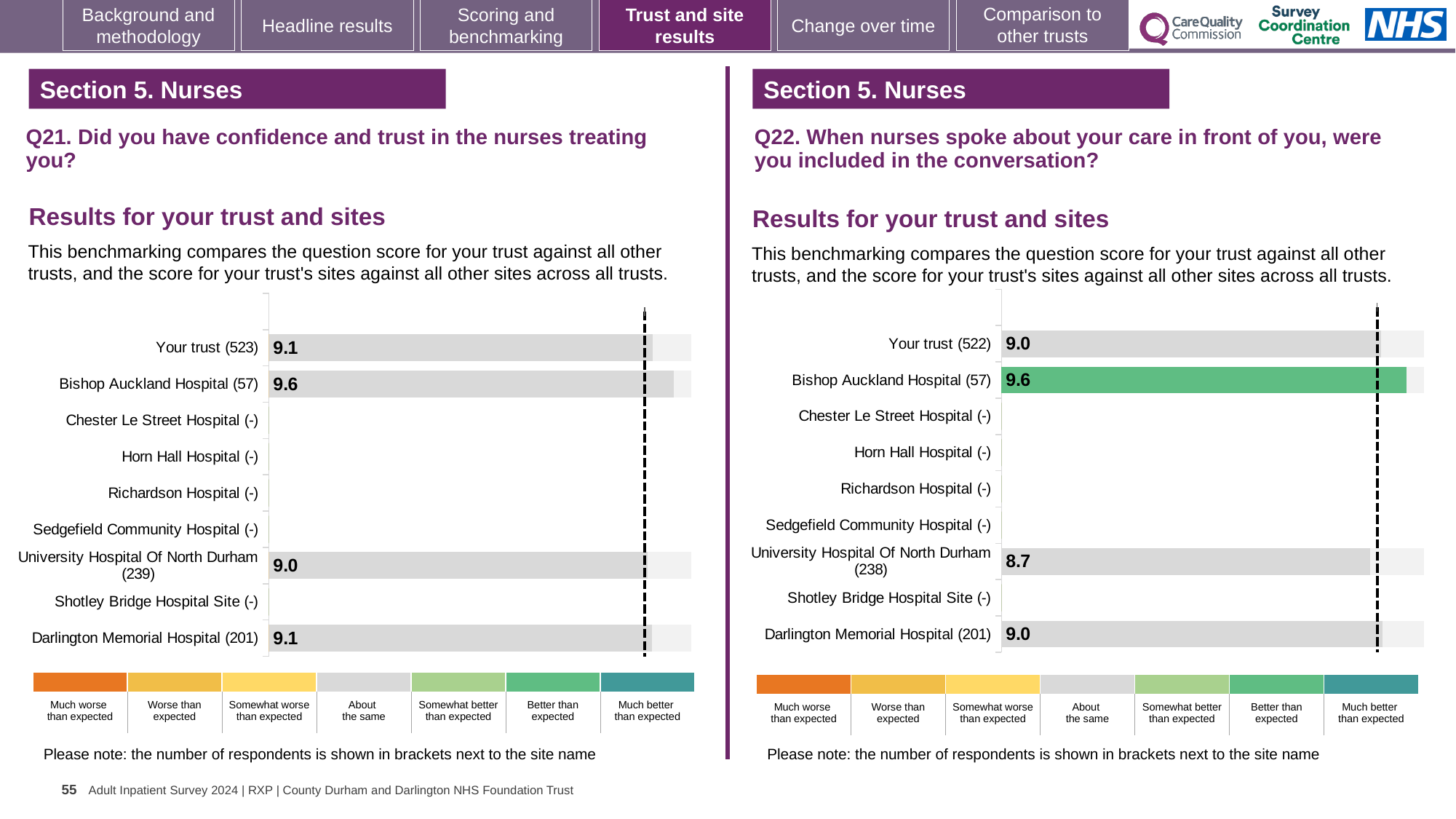
In the Q22 chart on the right, which site has the lowest score among those with a bar shown? University Hospital Of North Durham (238) In the Q22 chart on the right, which site's bar is coloured green (Better than expected)? Bishop Auckland Hospital (57) In the Q21 chart on the left, what is the score for Bishop Auckland Hospital (57)? 9.6 In the Q21 chart on the left, what is the score for University Hospital Of North Durham (239)? 9.0 In the Q22 chart on the right, what is the difference between the scores for Bishop Auckland Hospital (57) and Your trust (522)? 0.6 In the Q21 chart on the left, what is the score for Your trust (523)? 9.1 What kind of chart is used in the Q21 chart on the left? Bar chart In the Q22 chart on the right, what is the score for Darlington Memorial Hospital (201)? 9.0 In the Q22 chart on the right, what is the score for University Hospital Of North Durham (238)? 8.7 In the Q21 chart on the left, which site has the highest score? Bishop Auckland Hospital (57) In the Q21 chart on the left, what is the difference between the scores for Bishop Auckland Hospital (57) and University Hospital Of North Durham (239)? 0.6 In the Q22 chart on the right, which is larger: the score for Bishop Auckland Hospital (57) or the score for Your trust (522)? Bishop Auckland Hospital (57)